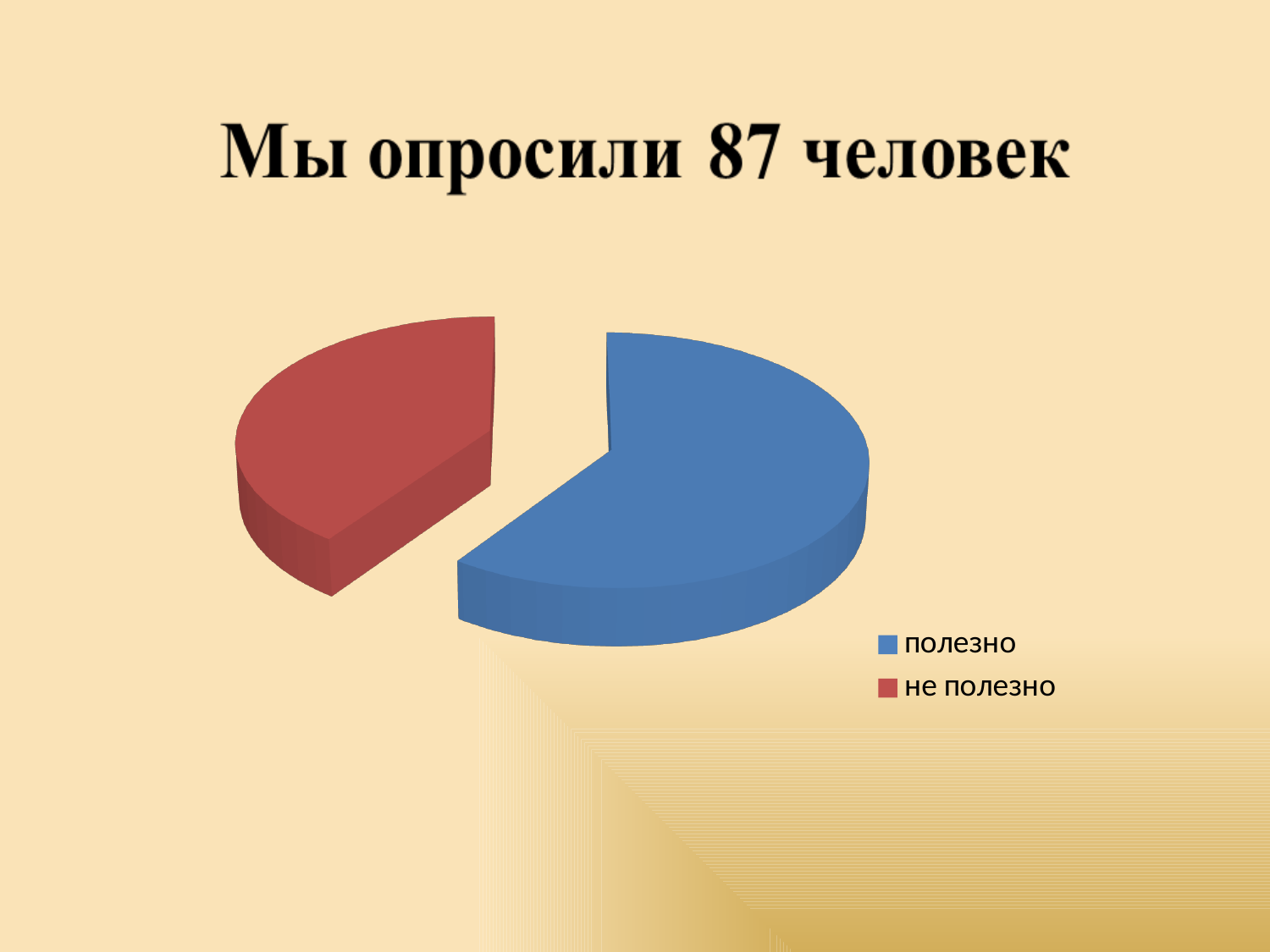
How many entries does the legend list? 2 What kind of chart is shown on the slide? pie chart What colour is the "полезно" slice? blue What colour is the "не полезно" slice? red Which category has the largest slice of the pie? полезно Which category has the smallest slice of the pie? не полезно How many slices does the pie chart have? 2 Which slice is larger, "полезно" or "не полезно"? полезно